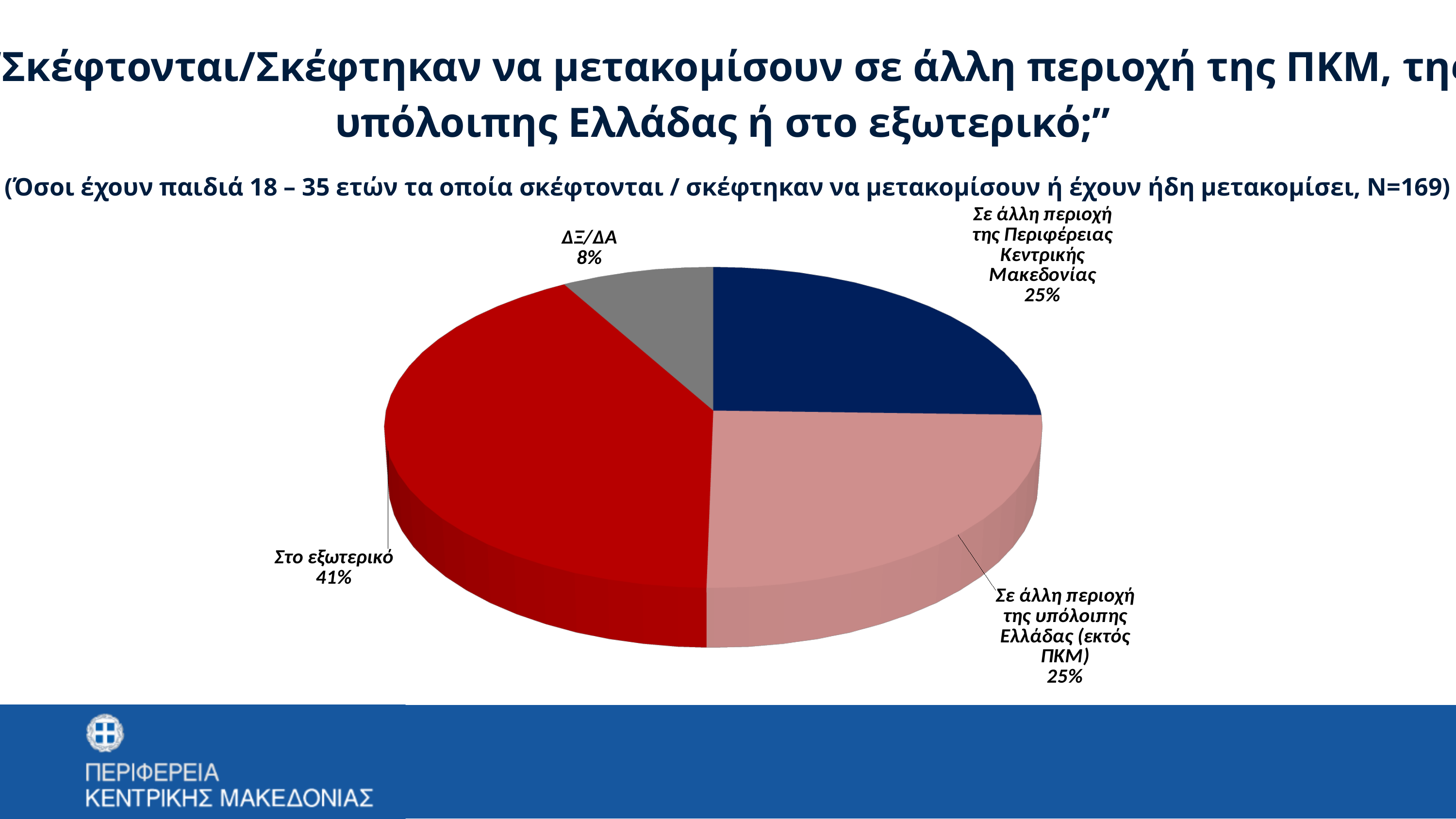
What type of chart is shown on the slide? Pie chart Which category has the smallest share of the pie? ΔΞ/ΔΑ How many slices does the pie chart have? 4 What percentage of respondents answered "Στο εξωτερικό"? 41% What is the difference in percentage points between "Στο εξωτερικό" and "ΔΞ/ΔΑ"? 33 Which category has the largest share of the pie? Στο εξωτερικό What percentage is shown for "ΔΞ/ΔΑ"? 8% Which is larger: the share for "Στο εξωτερικό" or the share for "Σε άλλη περιοχή της υπόλοιπης Ελλάδας (εκτός ΠΚΜ)"? Στο εξωτερικό What percentage is shown for "Σε άλλη περιοχή της Περιφέρειας Κεντρικής Μακεδονίας"? 25% What colour is the slice for "Στο εξωτερικό"? Red What is the difference in percentage points between "Στο εξωτερικό" and "Σε άλλη περιοχή της Περιφέρειας Κεντρικής Μακεδονίας"? 16 What percentage is shown for "Σε άλλη περιοχή της υπόλοιπης Ελλάδας (εκτός ΠΚΜ)"? 25%